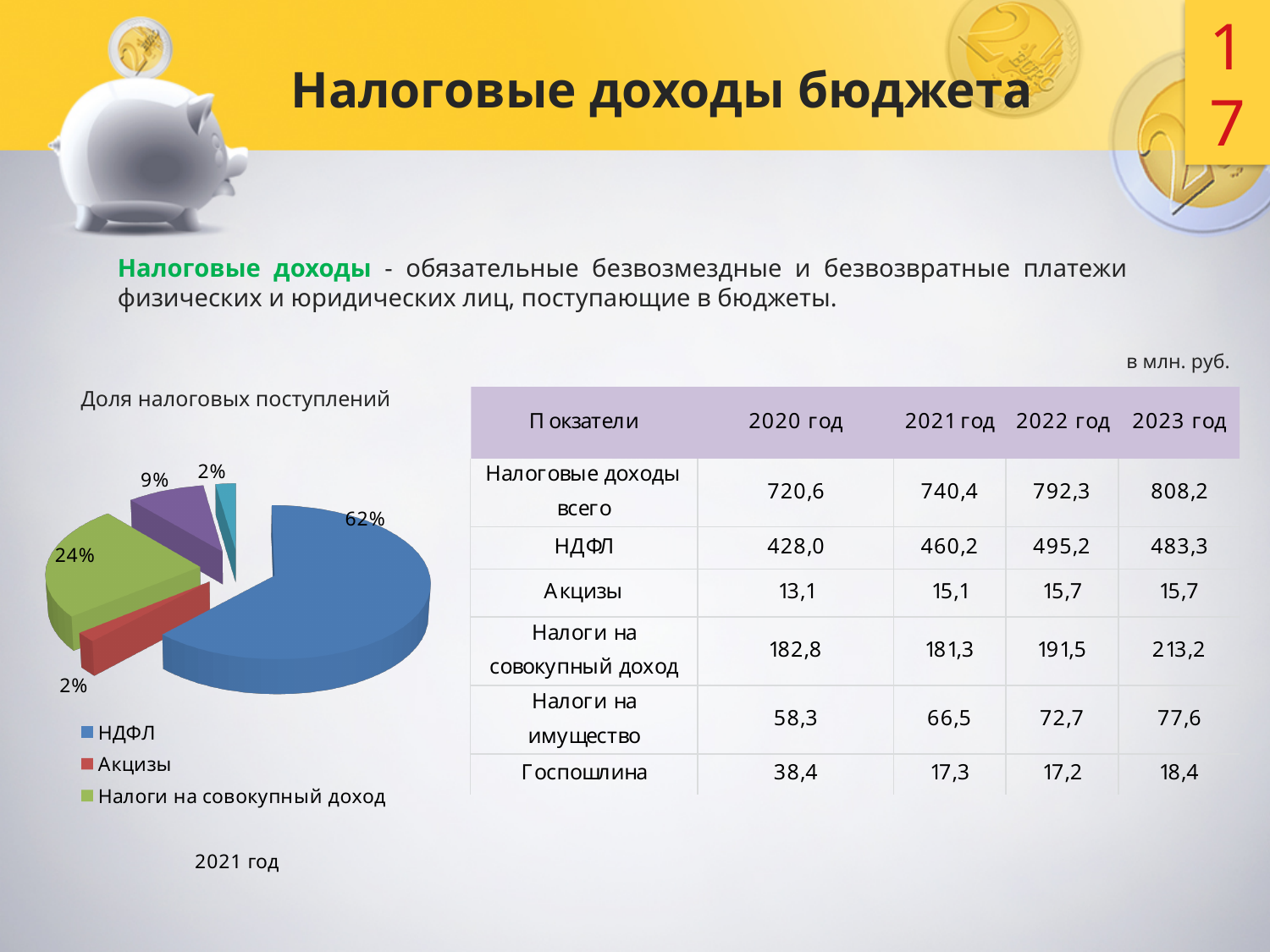
In the pie chart, by how many percentage points does the НДФЛ share exceed the Налоги на совокупный доход share? 38 percentage points In the pie chart, what share is shown for Акцизы? 2% In the pie chart, which is larger: the share for НДФЛ or the share for Налоги на совокупный доход? НДФЛ Which category has the largest slice in the pie chart? НДФЛ How many slices does the pie chart have? 5 In the pie chart, what share is shown for Налоги на совокупный доход? 24% Of the three categories listed in the pie chart's legend, which has the smallest share? Акцизы What kind of chart is shown on the left of the slide? pie chart In the pie chart, what share is shown for НДФЛ? 62% What is the title of the pie chart? Доля налоговых поступлений How many entries does the pie chart's legend list? 3 Which year is indicated below the pie chart? 2021 год